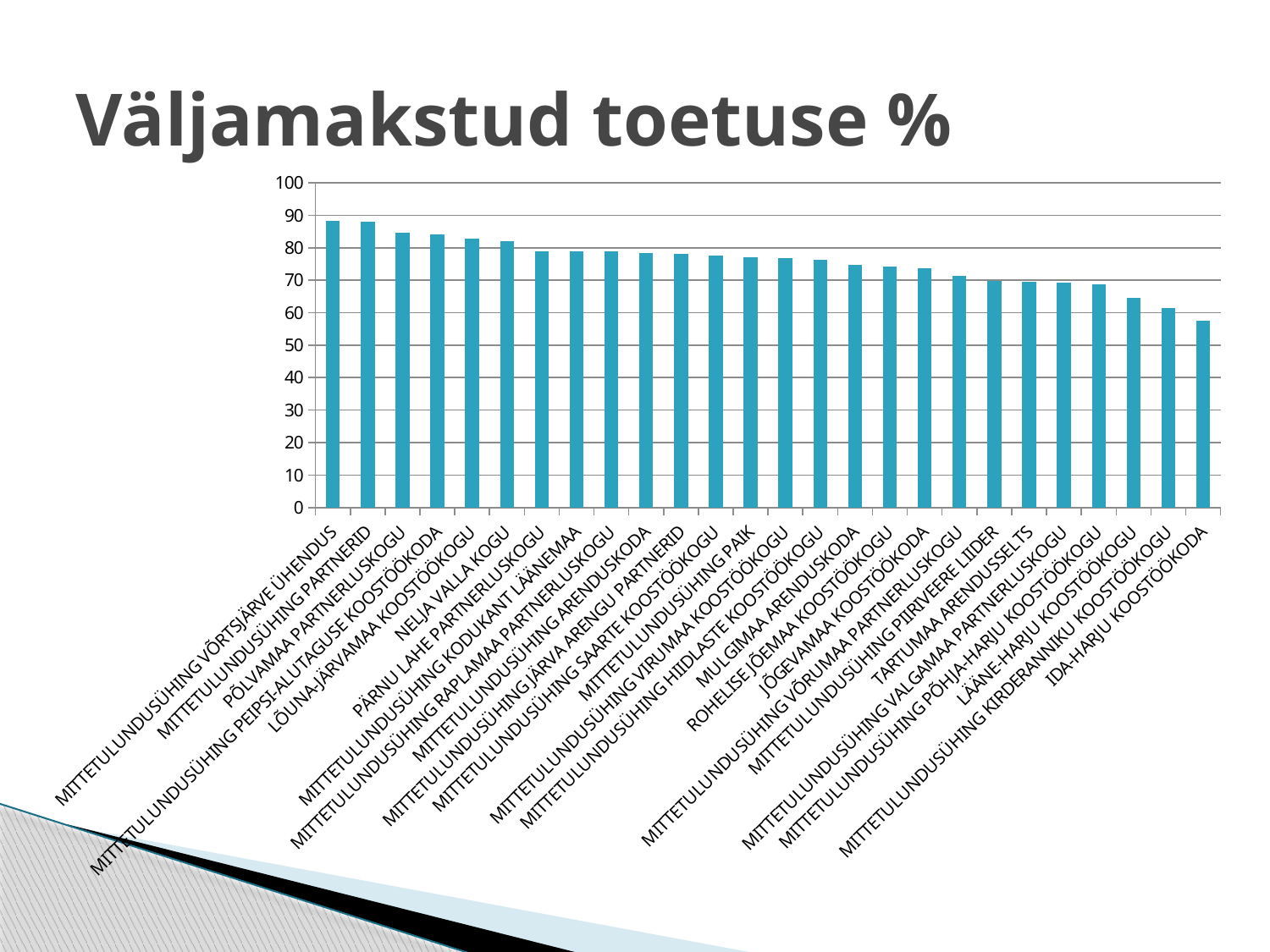
Which has the larger value: MITTETULUNDUSÜHING VÕRTSJÄRVE ÜHENDUS or IDA-HARJU KOOSTÖÖKODA? MITTETULUNDUSÜHING VÕRTSJÄRVE ÜHENDUS What kind of chart is shown on the slide? bar chart Is the value for MULGIMAA ARENDUSKODA greater or less than 70? greater Is the value for LÄÄNE-HARJU KOOSTÖÖKOGU greater or less than 60? greater Do the values rise or fall from left to right along the x axis? fall What is the title of the chart on the slide? Väljamakstud toetuse % Is the value for IDA-HARJU KOOSTÖÖKODA greater or less than 60? less Which has the larger value: PÕLVAMAA PARTNERLUSKOGU or LÄÄNE-HARJU KOOSTÖÖKOGU? PÕLVAMAA PARTNERLUSKOGU How many bars (categories) does the chart show? 26 Which category has the lowest value in the chart? IDA-HARJU KOOSTÖÖKODA